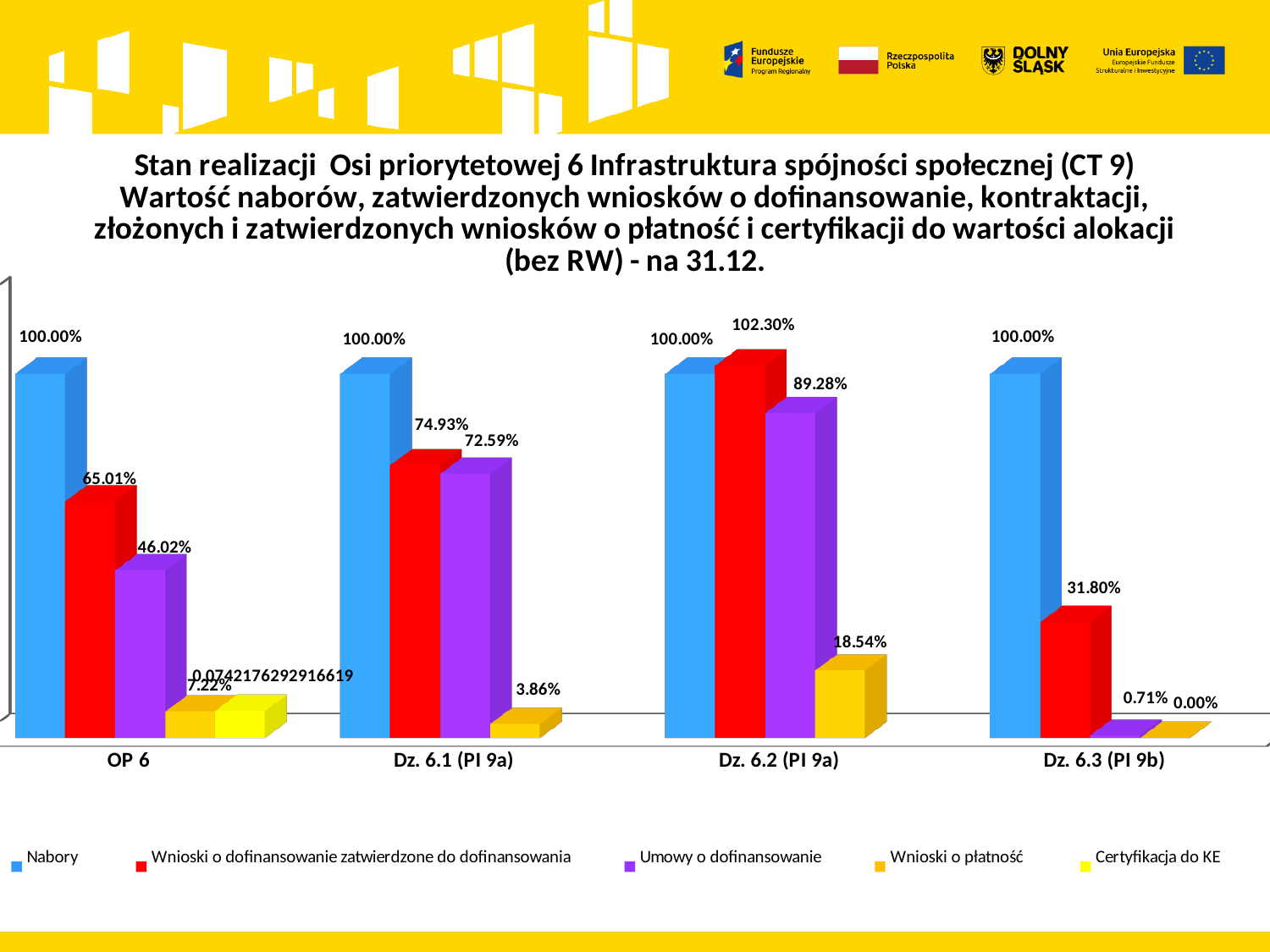
Which category has the highest value for Umowy o dofinansowanie? Dz. 6.2 (PI 9a) Which category has the lowest value for Wnioski o dofinansowanie zatwierdzone do dofinansowania? Dz. 6.3 (PI 9b) Which is larger for Dz. 6.1 (PI 9a): Wnioski o dofinansowanie zatwierdzone do dofinansowania or Umowy o dofinansowanie? Wnioski o dofinansowanie zatwierdzone do dofinansowania What is the value of Wnioski o dofinansowanie zatwierdzone do dofinansowania for Dz. 6.2 (PI 9a)? 102.30% What is the value of Umowy o dofinansowanie for Dz. 6.1 (PI 9a)? 72.59% What type of chart is shown on the slide? bar chart How many series does the legend list? 5 What is the value of Wnioski o płatność for Dz. 6.2 (PI 9a)? 18.54% How many categories are shown on the x axis of the chart? 4 What is the value of Wnioski o dofinansowanie zatwierdzone do dofinansowania for Dz. 6.3 (PI 9b)? 31.80% Which colour represents the Nabory series in the chart? blue What is the difference between Wnioski o dofinansowanie zatwierdzone do dofinansowania and Umowy o dofinansowanie for OP 6? 18.99%